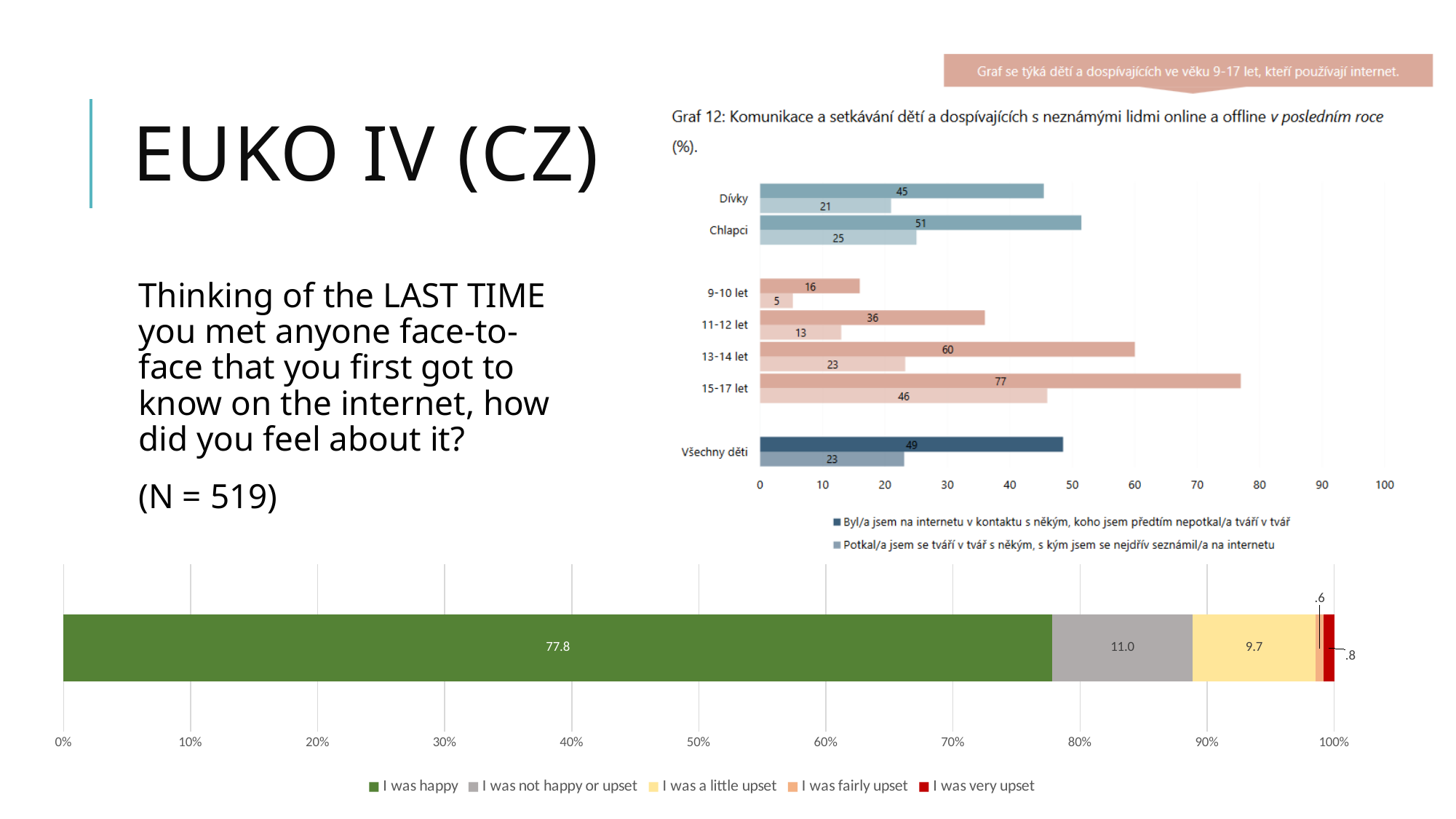
What kind of chart is the Graf 12 chart? Bar chart In the bottom stacked bar chart, which response has the largest segment? I was happy In the bottom stacked bar chart, what is the value for "I was very upset"? .8 In the bottom stacked bar chart, what is the value for "I was a little upset"? 9.7 In the Graf 12 chart, which age group has the highest value for the darker series? 15-17 let In the Graf 12 chart, which is larger for the darker series: Dívky or Chlapci? Chlapci In the Graf 12 chart, what is the difference between the two bars for Všechny děti? 26 In the bottom stacked bar chart, what is the difference between "I was not happy or upset" and "I was a little upset"? 1.3 How many series does the legend of the bottom stacked bar chart list? 5 In the Graf 12 chart, what is the value of the lighter bar for 9-10 let? 5 In the Graf 12 chart, what is the value of the darker bar for 15-17 let? 77 In the bottom stacked bar chart, what percentage of respondents said "I was happy"? 77.8